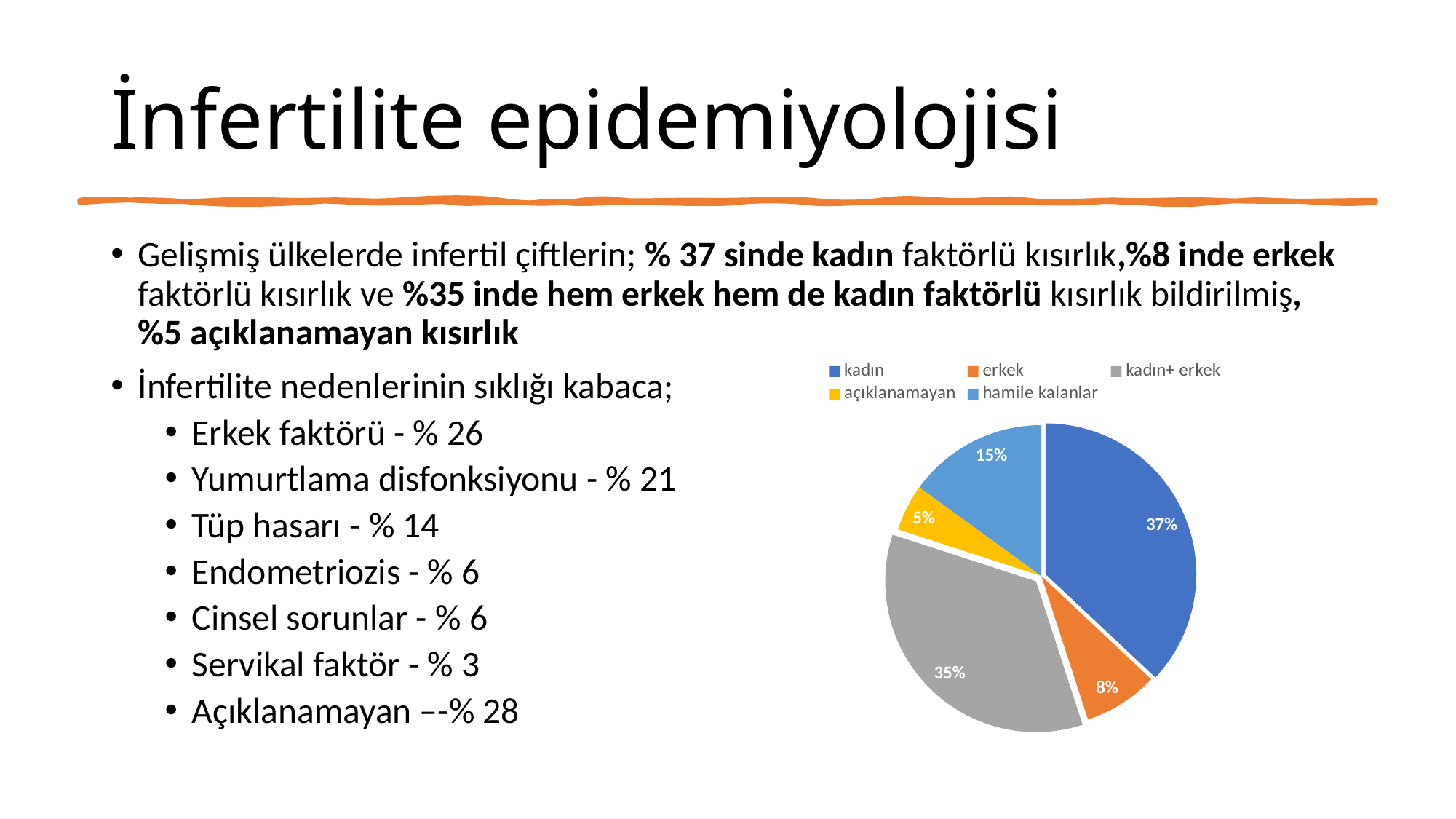
Which category has the smallest slice of the pie? açıklanamayan How many categories does the legend list? 5 What percentage does the 'kadın' slice show? 37% What is the difference between the 'kadın' and 'erkek' slices? 29% What colour is the 'kadın+ erkek' slice? grey What percentage does the 'hamile kalanlar' slice show? 15% What percentage does the 'kadın+ erkek' slice show? 35% Which category has the largest slice of the pie? kadın Which is larger, the 'hamile kalanlar' slice or the 'erkek' slice? hamile kalanlar What percentage does the 'açıklanamayan' slice show? 5% What kind of chart is shown on the slide? pie chart What percentage does the 'erkek' slice show? 8%